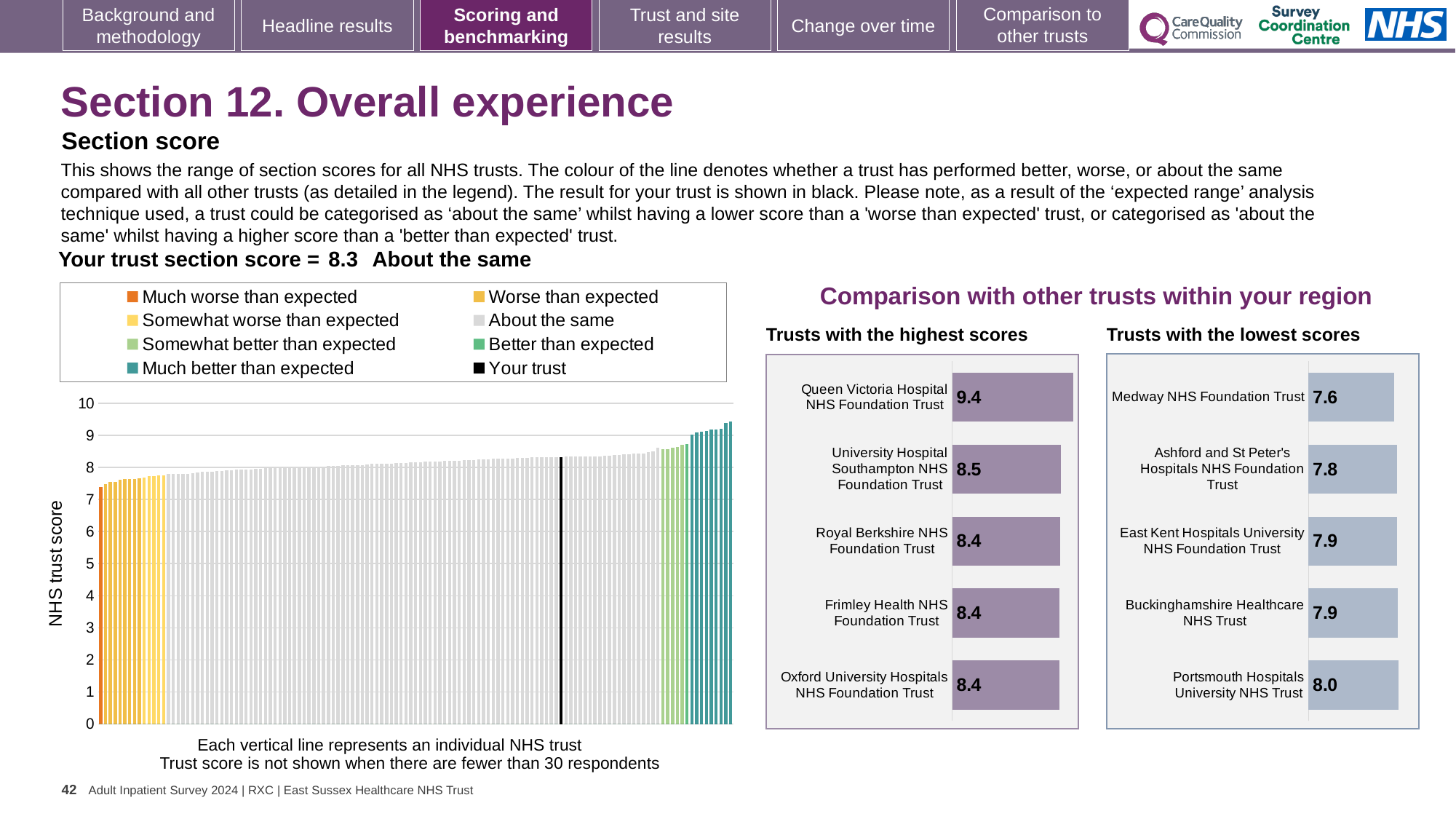
In the 'Trusts with the lowest scores' chart, what is the score for Medway NHS Foundation Trust? 7.6 In the 'Trusts with the lowest scores' chart, what is the difference between the scores of Portsmouth Hospitals University NHS Trust and Medway NHS Foundation Trust? 0.4 In the 'Trusts with the highest scores' chart, what is the score for Queen Victoria Hospital NHS Foundation Trust? 9.4 In the 'Trusts with the highest scores' chart, which trust has the highest score? Queen Victoria Hospital NHS Foundation Trust In the 'Trusts with the lowest scores' chart, which has the larger score: Ashford and St Peter's Hospitals NHS Foundation Trust or Portsmouth Hospitals University NHS Trust? Portsmouth Hospitals University NHS Trust In the large chart on the left showing all NHS trusts, do the scores rise or fall from left to right? Rise In the large chart on the left showing all NHS trusts, what kind of chart is it? Bar chart In the 'Trusts with the highest scores' chart, how many trusts are shown? 5 In the large chart on the left showing all NHS trusts, how many entries does the legend list? 8 In the 'Trusts with the lowest scores' chart, which trust has the lowest score? Medway NHS Foundation Trust In the 'Trusts with the highest scores' chart, what is the difference between the scores of Queen Victoria Hospital NHS Foundation Trust and University Hospital Southampton NHS Foundation Trust? 0.9 In the 'Trusts with the highest scores' chart, what is the score for University Hospital Southampton NHS Foundation Trust? 8.5